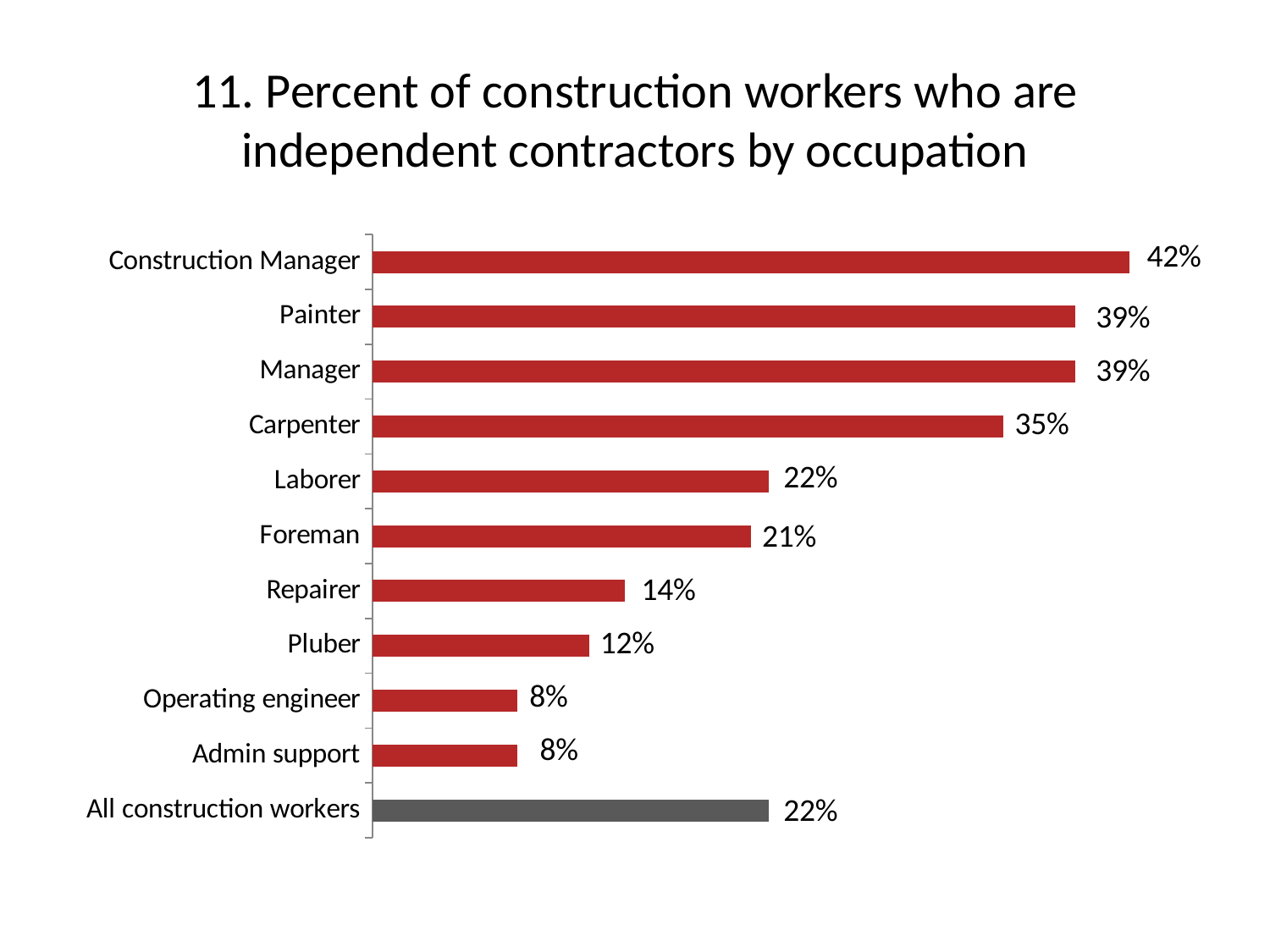
How many categories are shown on the chart? 11 What is the difference between the values for Construction Manager and Carpenter? 7% What percent of construction managers are independent contractors? 42% Which is larger, the value for Painter or the value for Carpenter? Painter What is the difference between the values for Laborer and Foreman? 1% What is the value shown for Carpenter? 35% Which occupation has the highest percent of independent contractors? Construction Manager What kind of chart is shown on the slide? Bar chart Which bar is shown in a different colour (grey) from the others? All construction workers What is the value shown for All construction workers? 22% Which is larger, the value for Pluber or the value for Repairer? Repairer What is the value shown for Repairer? 14%